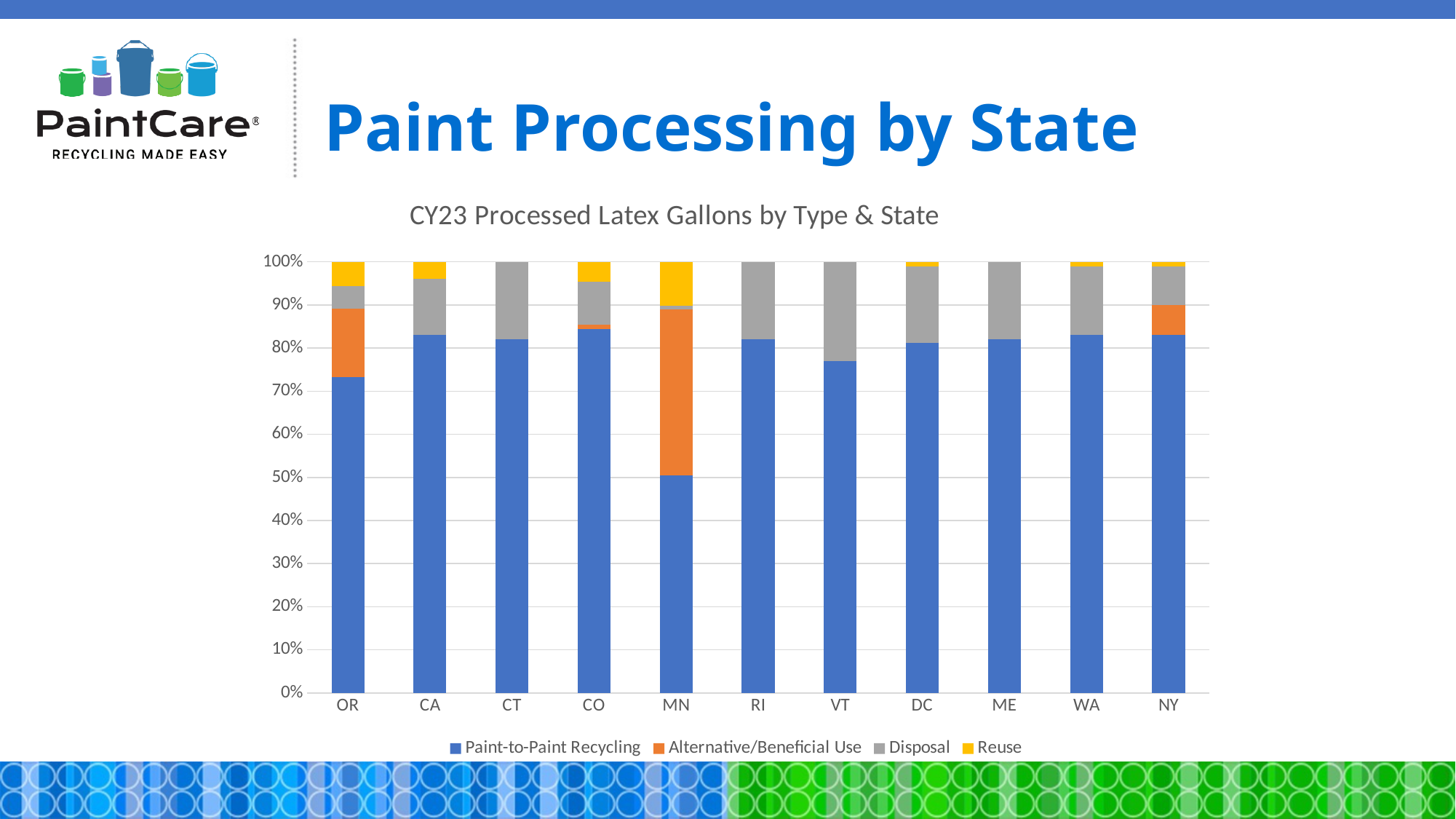
What kind of chart is shown on the slide? Stacked bar chart How many states are shown on the x axis of the chart? 11 Is the Paint-to-Paint Recycling share for OR greater or less than 60%? greater Is the Paint-to-Paint Recycling share for VT greater or less than 80%? less Which state has a larger Paint-to-Paint Recycling share, OR or MN? OR How many series does the chart legend list? 4 What is the title of the chart? CY23 Processed Latex Gallons by Type & State Which state has the lowest share of Paint-to-Paint Recycling? MN Is the Paint-to-Paint Recycling share for MN greater or less than 60%? less Which state has the largest share of Alternative/Beneficial Use? MN Which state has the largest share of Disposal? VT Which colour represents Reuse in the chart? Yellow